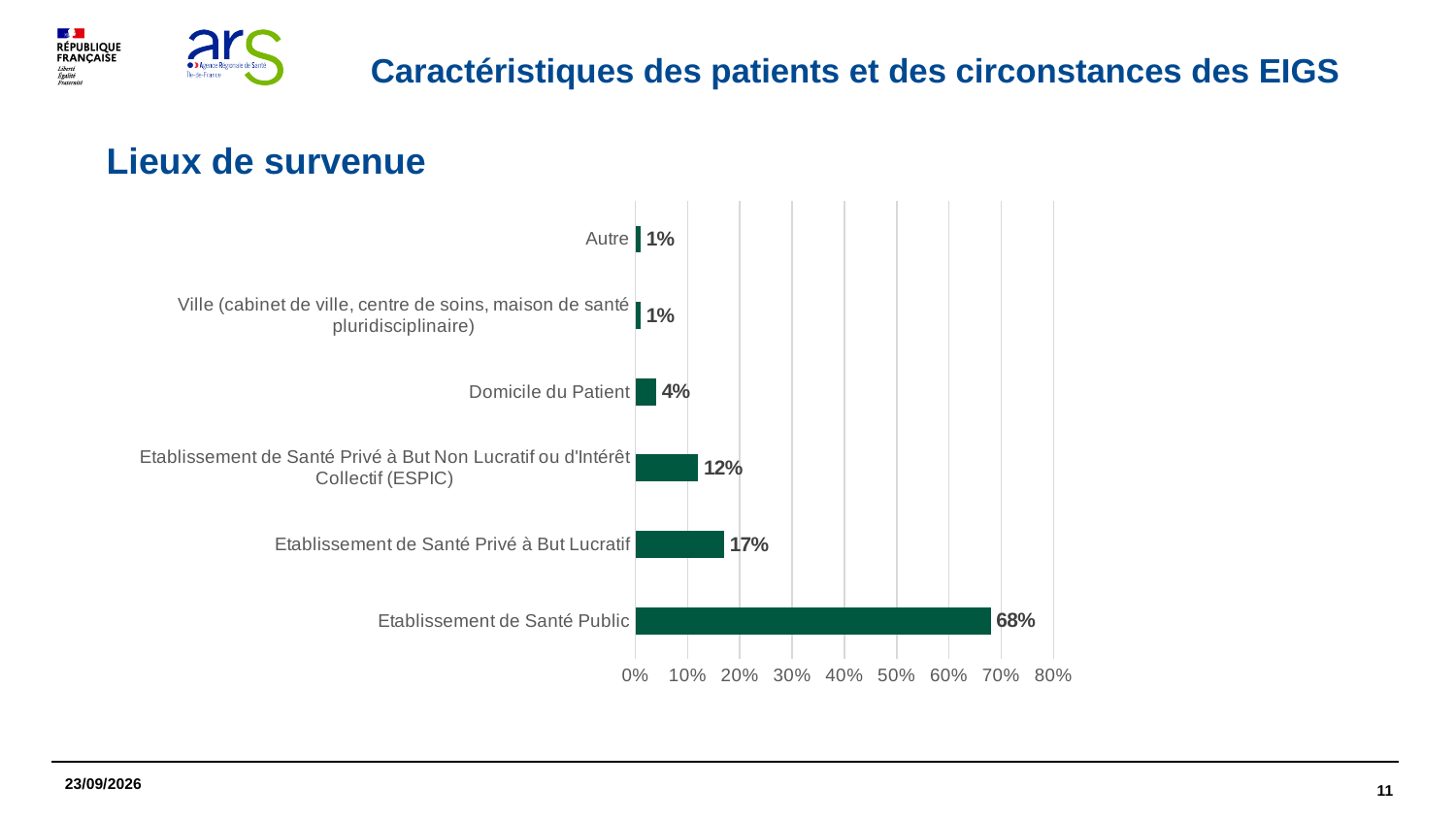
What is the value for Etablissement de Santé Privé à But Lucratif? 17% What is the title of the chart section on the slide? Lieux de survenue What is the value for Etablissement de Santé Privé à But Non Lucratif ou d'Intérêt Collectif (ESPIC)? 12% What is the difference between Etablissement de Santé Public and Etablissement de Santé Privé à But Lucratif? 51% What is the value for Etablissement de Santé Public? 68% Is the value for Etablissement de Santé Public greater or less than 60%? greater What is the value for Domicile du Patient? 4% How many categories are shown in the chart? 6 Which category has the highest value? Etablissement de Santé Public What kind of chart is shown on the slide? Bar chart Which is larger, Domicile du Patient or Etablissement de Santé Privé à But Lucratif? Etablissement de Santé Privé à But Lucratif What is the difference between Etablissement de Santé Privé à But Lucratif and the ESPIC category? 5%